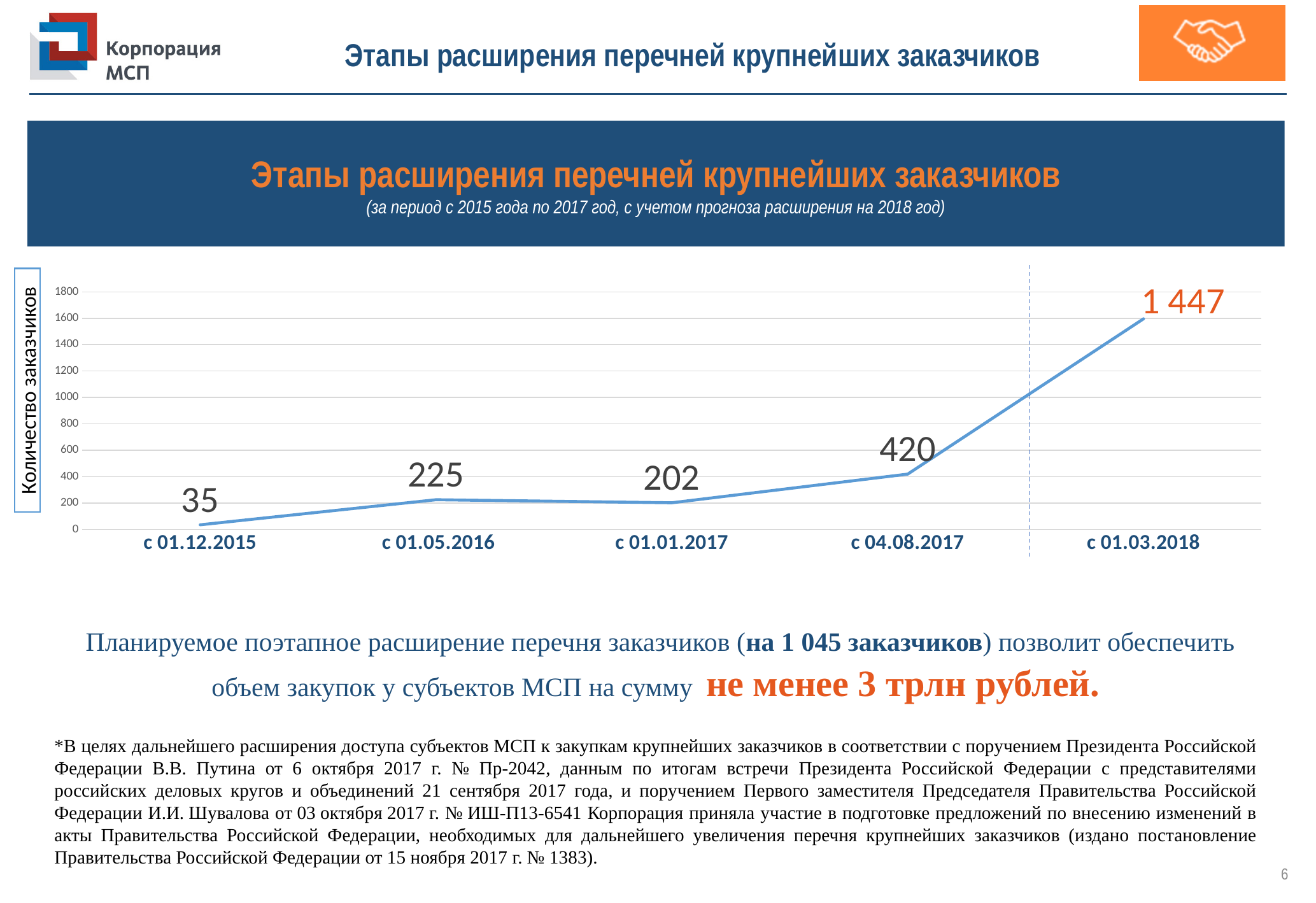
What is the value plotted for с 01.01.2017? 202 How many data points are plotted on the chart? 5 What is the number of customers (Количество заказчиков) for с 01.12.2015? 35 Which is larger, the value for с 01.05.2016 or the value for с 01.01.2017? с 01.05.2016 What is the value plotted for с 04.08.2017? 420 What is the difference between the values for с 01.03.2018 and с 04.08.2017? 1 027 What is the value plotted for с 01.05.2016? 225 What is the label of the vertical axis of the chart? Количество заказчиков What type of chart is shown on the slide? line chart Which date has the lowest value on the chart? с 01.12.2015 What is the value plotted for с 01.03.2018? 1 447 Which date has the highest value on the chart? с 01.03.2018